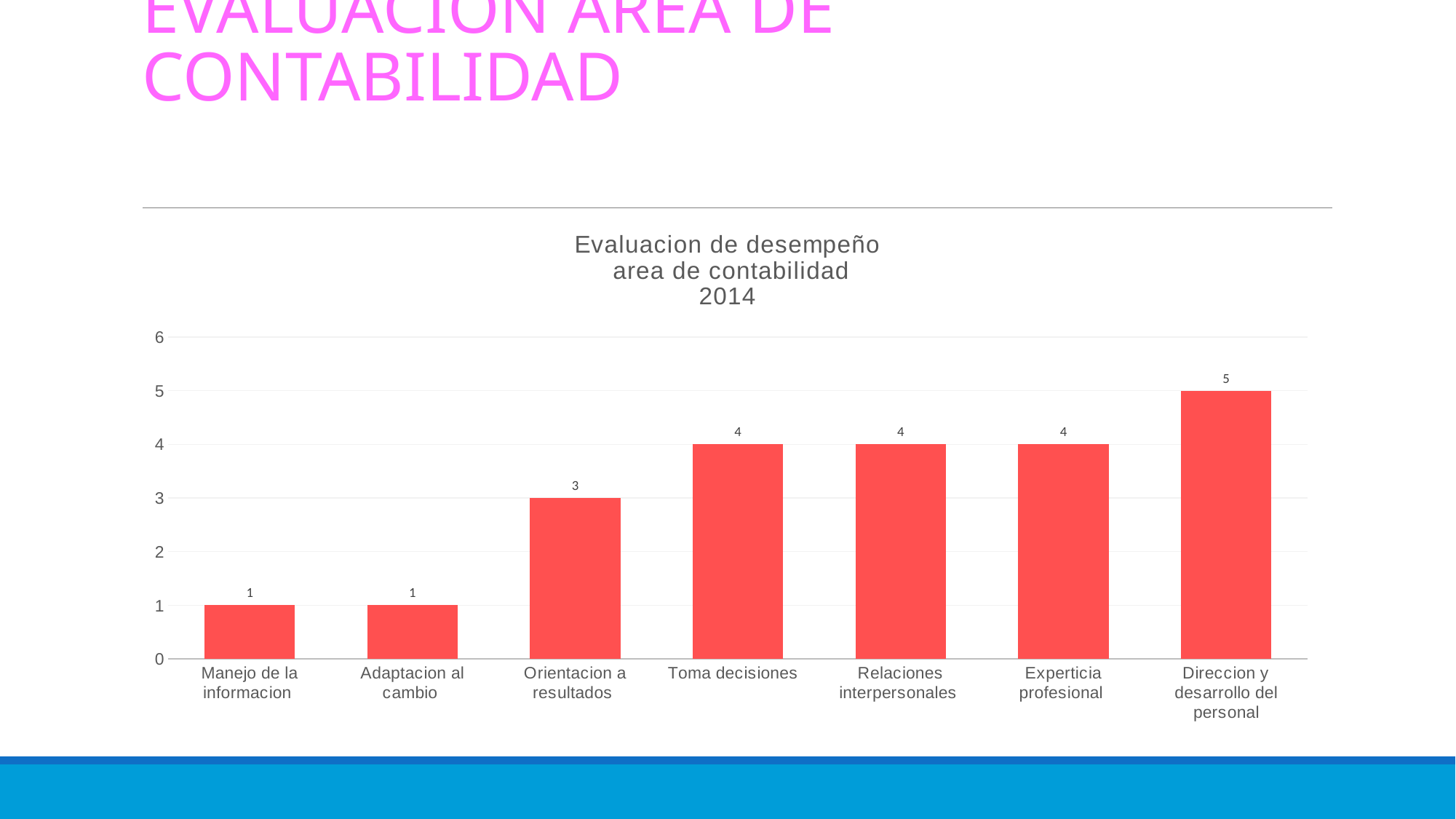
What is the value for Toma decisiones? 4 Which is larger, the value for Orientacion a resultados or the value for Experticia profesional? Experticia profesional How many categories are shown on the x axis? 7 Is the value for Relaciones interpersonales greater or less than 3? greater What is the difference between the values for Toma decisiones and Adaptacion al cambio? 3 What is the value for Orientacion a resultados? 3 Which category has the highest value? Direccion y desarrollo del personal What is the title of the chart? Evaluacion de desempeño area de contabilidad 2014 Do the values generally rise or fall from left to right along the x axis? rise What is the difference between the values for Direccion y desarrollo del personal and Manejo de la informacion? 4 What is the value for Direccion y desarrollo del personal? 5 What kind of chart is shown on the slide? bar chart